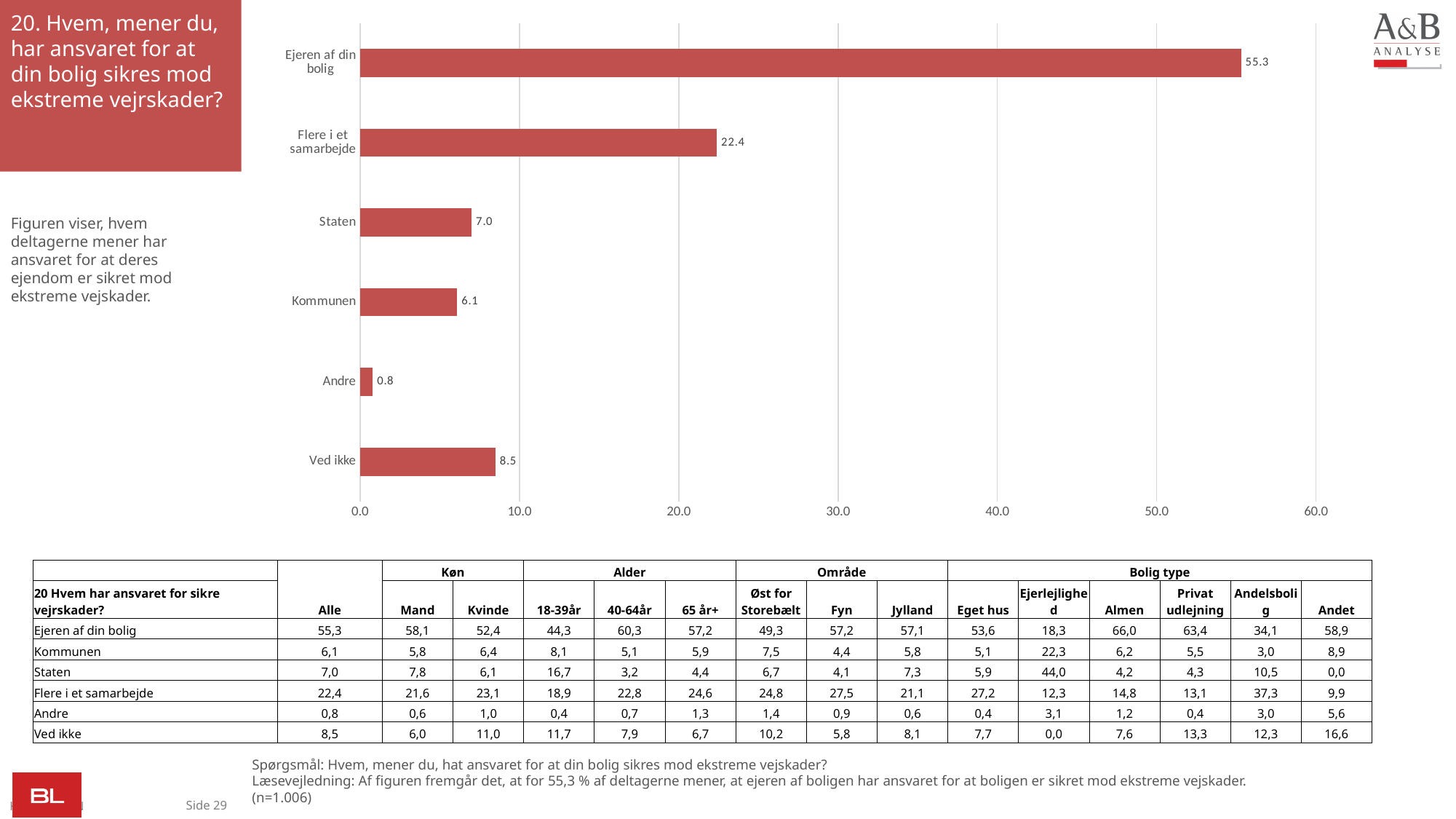
What value is shown for "Ved ikke"? 8.5 What kind of chart is shown on the slide? Bar chart What value is shown for "Kommunen"? 6.1 Which category has the lowest value? Andre Which is larger, the value for "Staten" or the value for "Kommunen"? Staten Is the value for "Flere i et samarbejde" greater or less than 20.0? greater What value is shown for "Ejeren af din bolig"? 55.3 How many categories are shown in the bar chart? 6 What value is shown for "Flere i et samarbejde"? 22.4 What is the difference between the values for "Ejeren af din bolig" and "Flere i et samarbejde"? 32.9 What is the highest value shown on the horizontal axis of the chart? 60.0 Which category has the highest value? Ejeren af din bolig